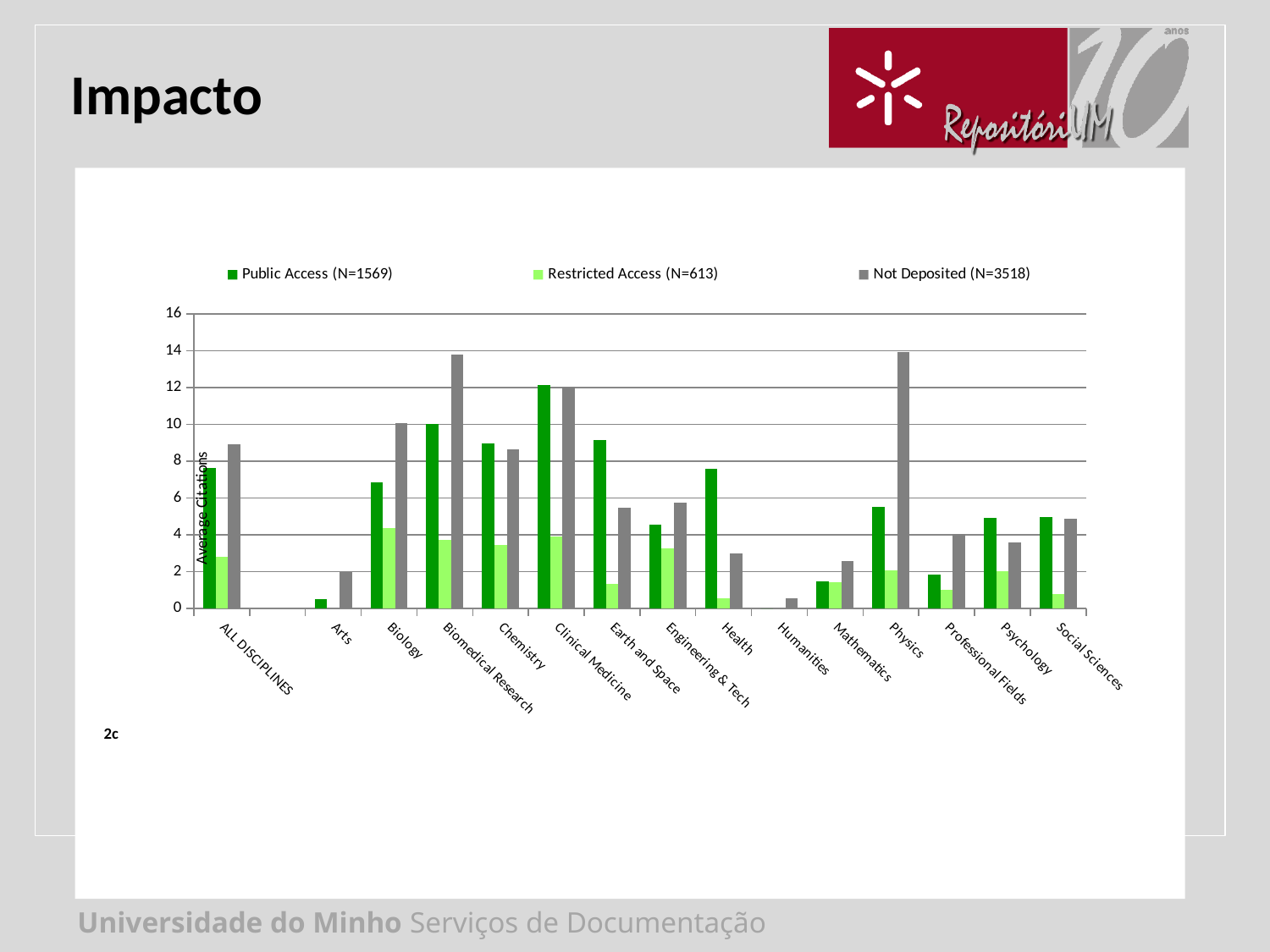
What kind of chart is shown on the slide? bar chart For Earth and Space, which is larger: the Public Access (N=1569) value or the Not Deposited (N=3518) value? Public Access (N=1569) Is the Public Access (N=1569) value for Arts greater or less than 2? less Is the Public Access (N=1569) value for Clinical Medicine greater or less than 10? greater How many discipline categories are shown on the x axis? 15 Which category has the highest Public Access (N=1569) value? Clinical Medicine What is the label of the vertical axis? Average Citations For Biology, which is larger: the Public Access (N=1569) value or the Not Deposited (N=3518) value? Not Deposited (N=3518) What is the sample size shown in the legend for Restricted Access? N=613 Is the Public Access (N=1569) value for Health greater or less than 6? greater How many series does the legend list? 3